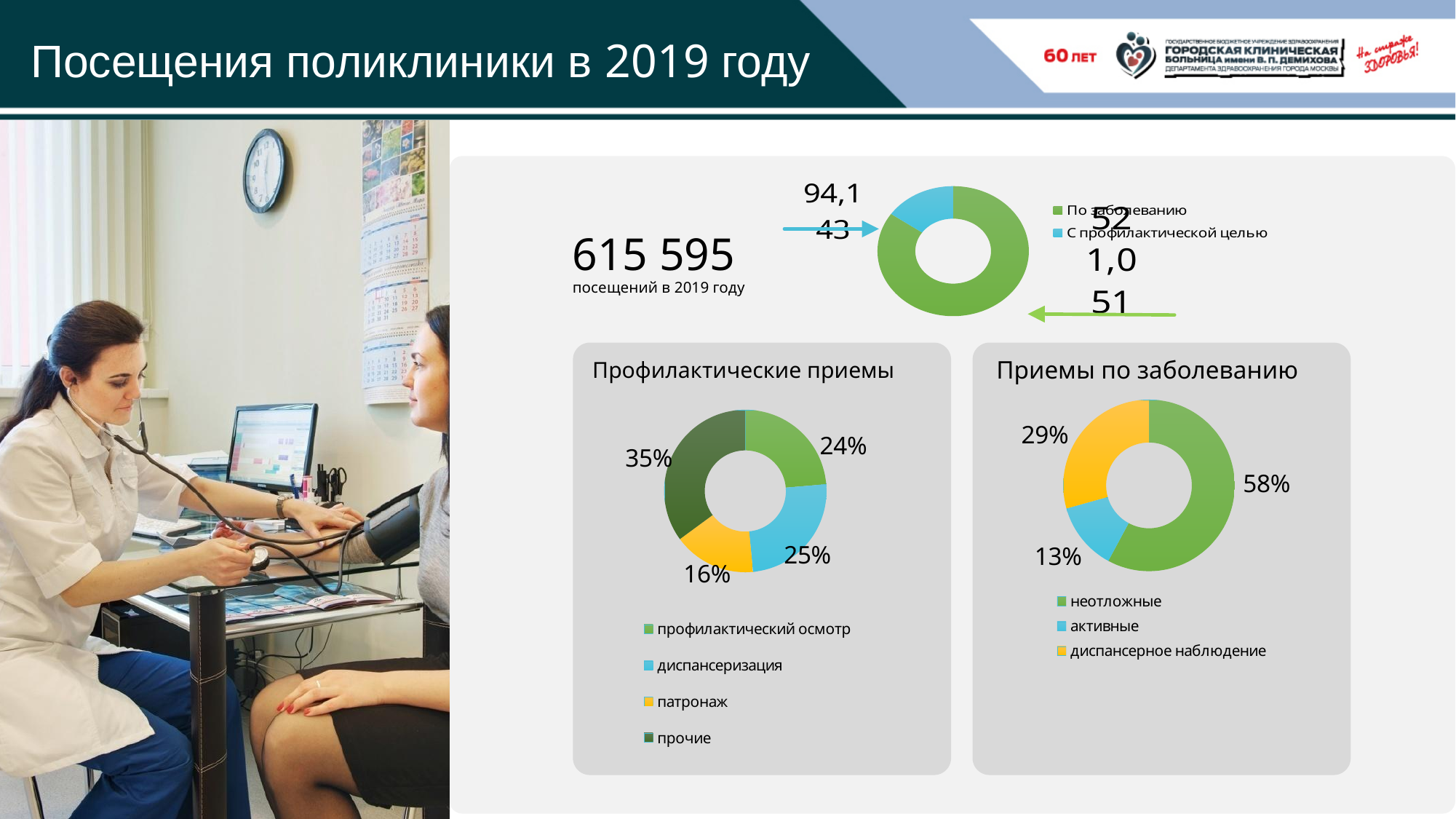
On the top chart next to '615 595', which segment is larger: 'По заболеванию' or 'С профилактической целью'? По заболеванию On the 'Профилактические приемы' chart, what share is 'патронаж'? 16% What kind of chart is used for 'Приемы по заболеванию'? Doughnut chart On the 'Профилактические приемы' chart, how many categories does the legend list? 4 On the 'Приемы по заболеванию' chart, what share is 'неотложные'? 58% On the 'Профилактические приемы' chart, what share is 'прочие'? 35% On the 'Профилактические приемы' chart, which category has the largest share? прочие On the 'Профилактические приемы' chart, what share is 'диспансеризация'? 25% On the 'Приемы по заболеванию' chart, which is larger: 'активные' or 'диспансерное наблюдение'? диспансерное наблюдение On the 'Профилактические приемы' chart, which category has the smallest share? патронаж On the 'Приемы по заболеванию' chart, what share is 'активные'? 13% On the 'Приемы по заболеванию' chart, what is the difference in percentage points between 'неотложные' and 'диспансерное наблюдение'? 29